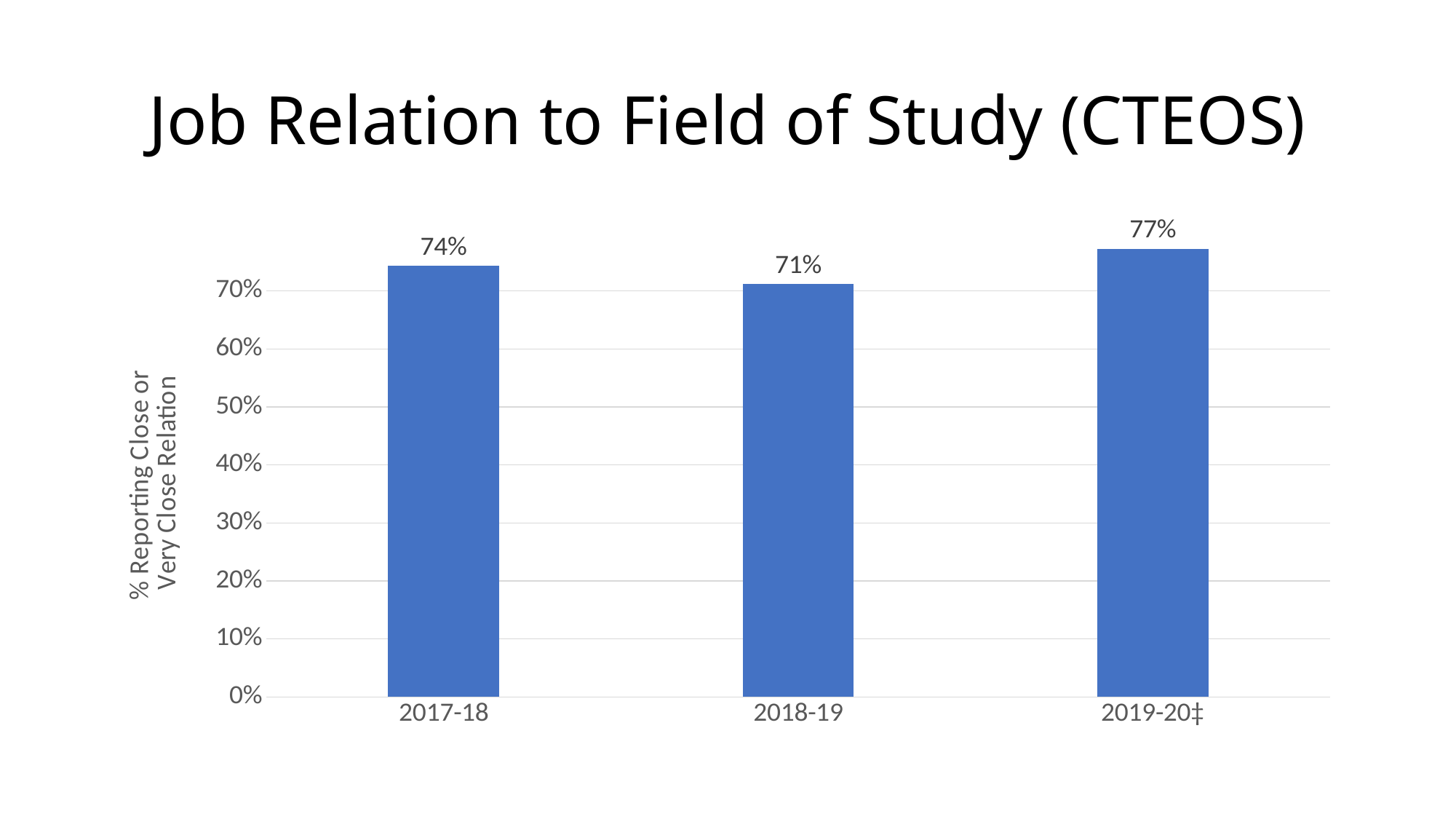
Is the value for 2018-19 greater or less than 60%? greater What is the difference between the values for 2017-18 and 2018-19? 3% What is the title of the chart? Job Relation to Field of Study (CTEOS) What is the value for 2017-18? 74% What is the value for 2019-20‡? 77% What is the difference between the values for 2019-20‡ and 2018-19? 6% What is the value for 2018-19? 71% How many years are shown on the chart? 3 Which is larger, the value for 2017-18 or the value for 2019-20‡? 2019-20‡ What kind of chart is shown on the slide? bar chart Which year has the lowest value? 2018-19 Which year has the highest value? 2019-20‡